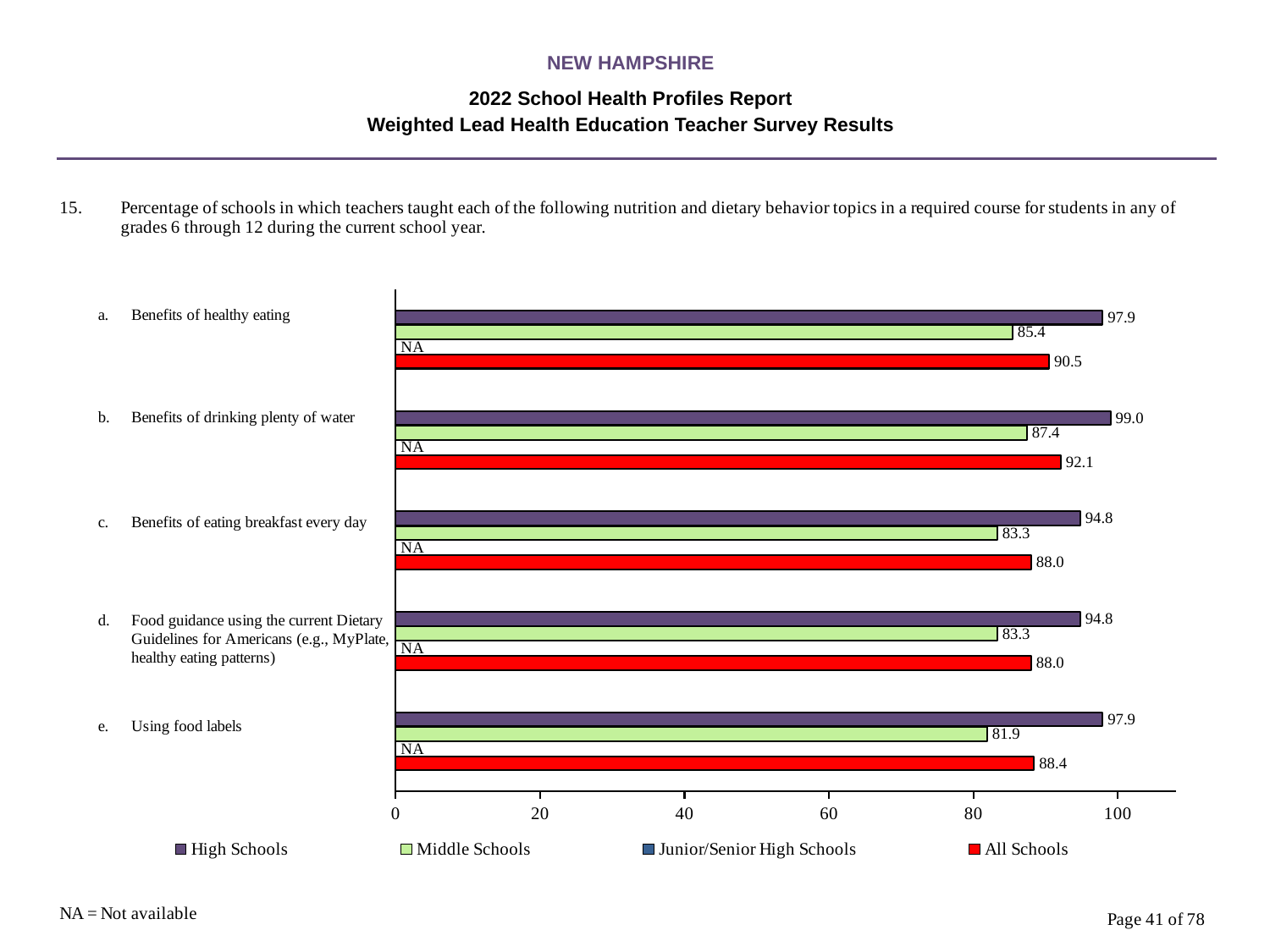
Which topic has the lowest Middle Schools value? Using food labels How many series does the legend list? 4 What value is shown for Junior/Senior High Schools for 'Benefits of healthy eating'? NA What kind of chart is shown? Bar chart What is the difference between the High Schools and Middle Schools values for 'Benefits of healthy eating'? 12.5 Which topic has the highest High Schools value? Benefits of drinking plenty of water How many topics (categories) are plotted on the chart? 5 What is the Middle Schools value for 'Using food labels'? 81.9 Which is larger for 'Using food labels': the All Schools value or the Middle Schools value? All Schools What is the All Schools value for 'Benefits of eating breakfast every day'? 88.0 Which series is shown in red in the legend? All Schools What is the High Schools value for 'Benefits of drinking plenty of water'? 99.0